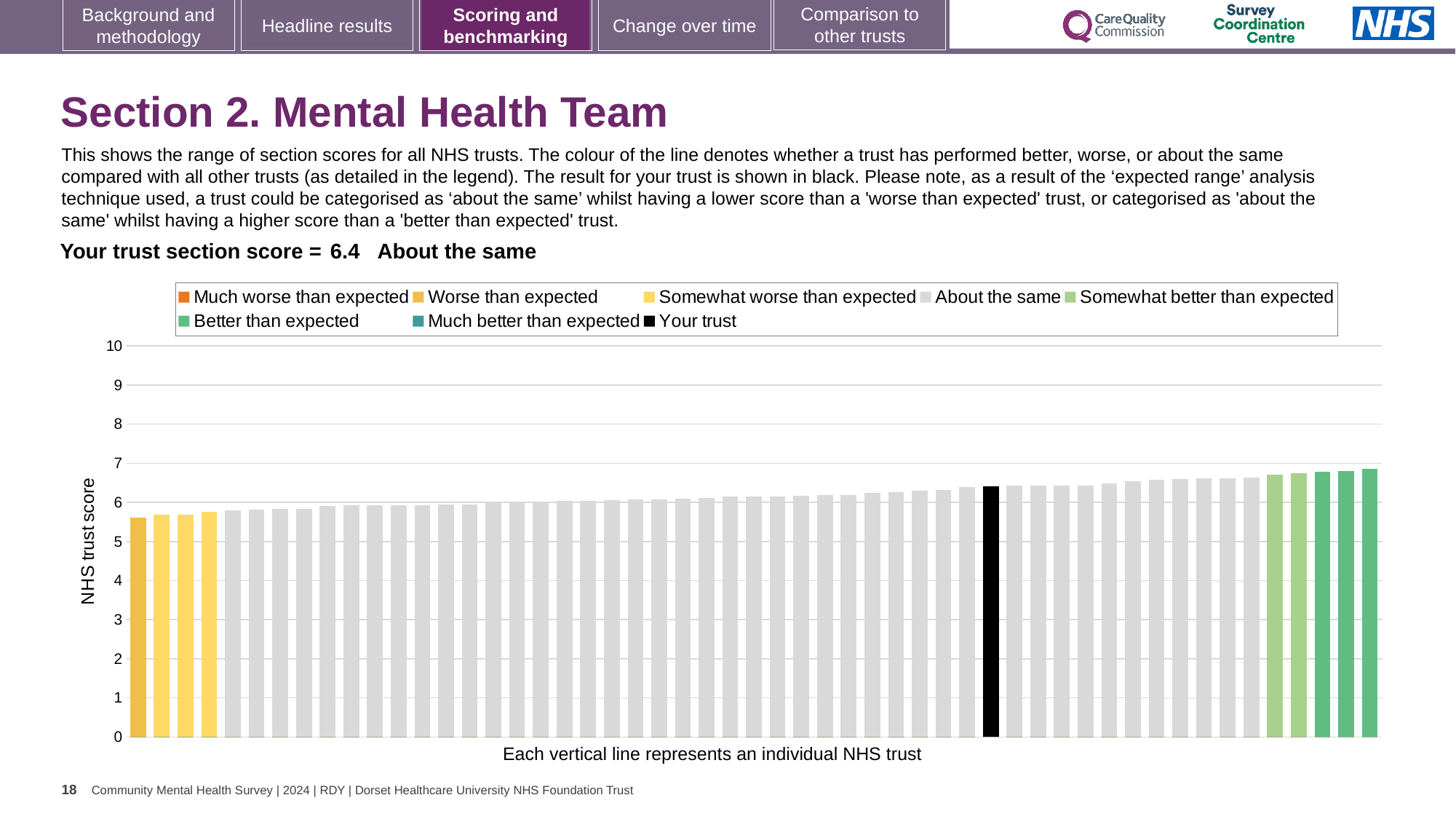
Is the value for your trust (the black bar) greater or less than 6? greater What is the label on the vertical axis of the chart? NHS trust score What is the section score for your trust shown on the slide? 6.4 What is the highest value shown on the vertical axis of the chart? 10 What kind of chart is shown on the slide? bar chart How many entries does the chart legend list? 8 Is the value of the shortest bar in the chart greater or less than 5? greater Which benchmarking category is your trust's section score placed in? About the same Which colour is used for the bar representing your trust? black Do the bar values rise or fall from left to right along the x axis? rise Is the value for your trust (the black bar) greater or less than 7? less